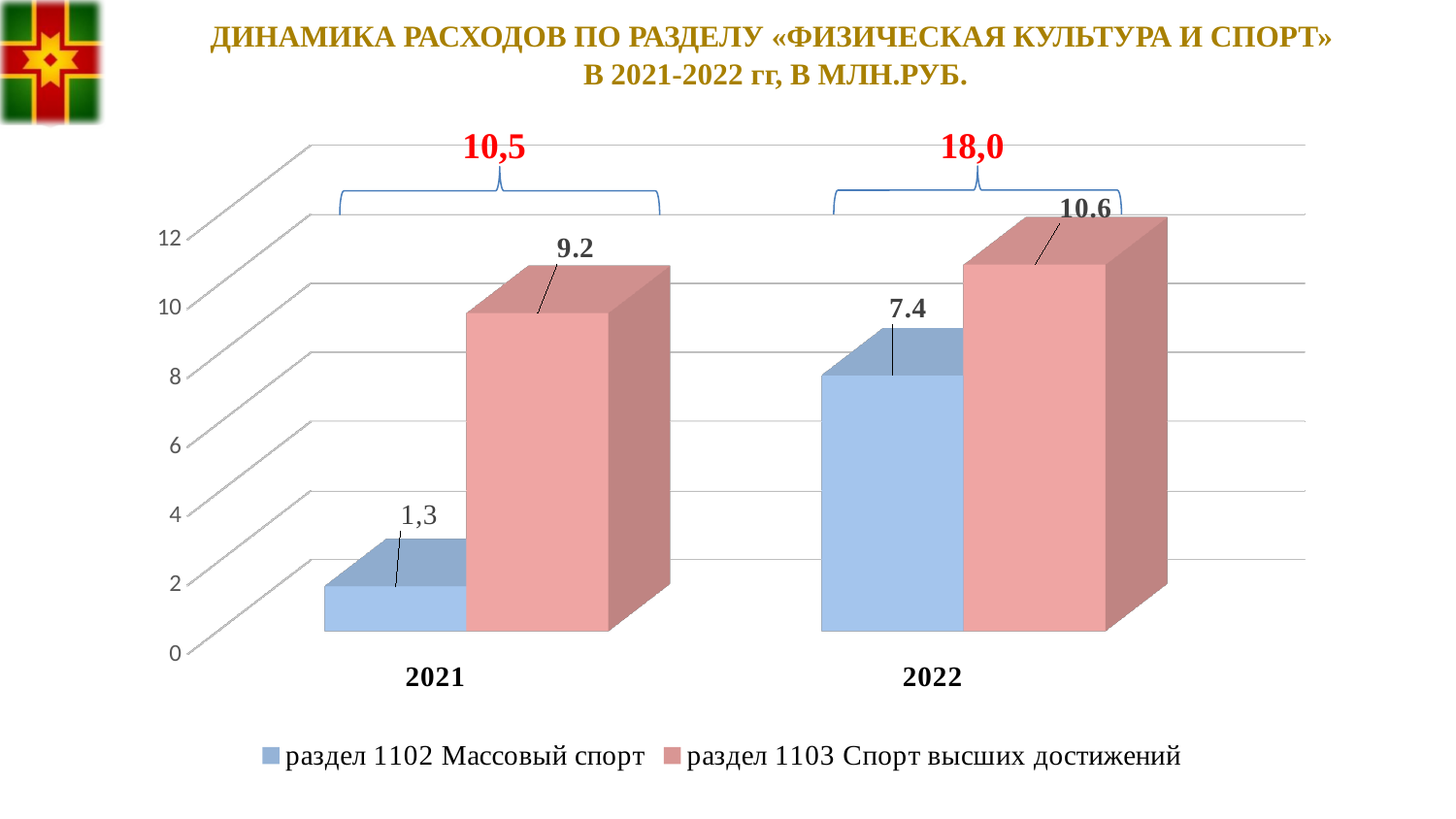
What is the value for раздел 1102 Массовый спорт in 2022? 7.4 What kind of chart is shown on the slide? bar chart Which year has the higher value for раздел 1102 Массовый спорт? 2022 What is the value for раздел 1103 Спорт высших достижений in 2022? 10.6 What is the value for раздел 1103 Спорт высших достижений in 2021? 9.2 How many series does the legend list? 2 How many years are shown on the x axis? 2 By how much did раздел 1103 Спорт высших достижений increase from 2021 to 2022? 1.4 What total is shown above the bars for 2021? 10,5 What total is shown above the bars for 2022? 18,0 Does the value for раздел 1102 Массовый спорт rise or fall from 2021 to 2022? rise What is the value for раздел 1102 Массовый спорт in 2021? 1,3